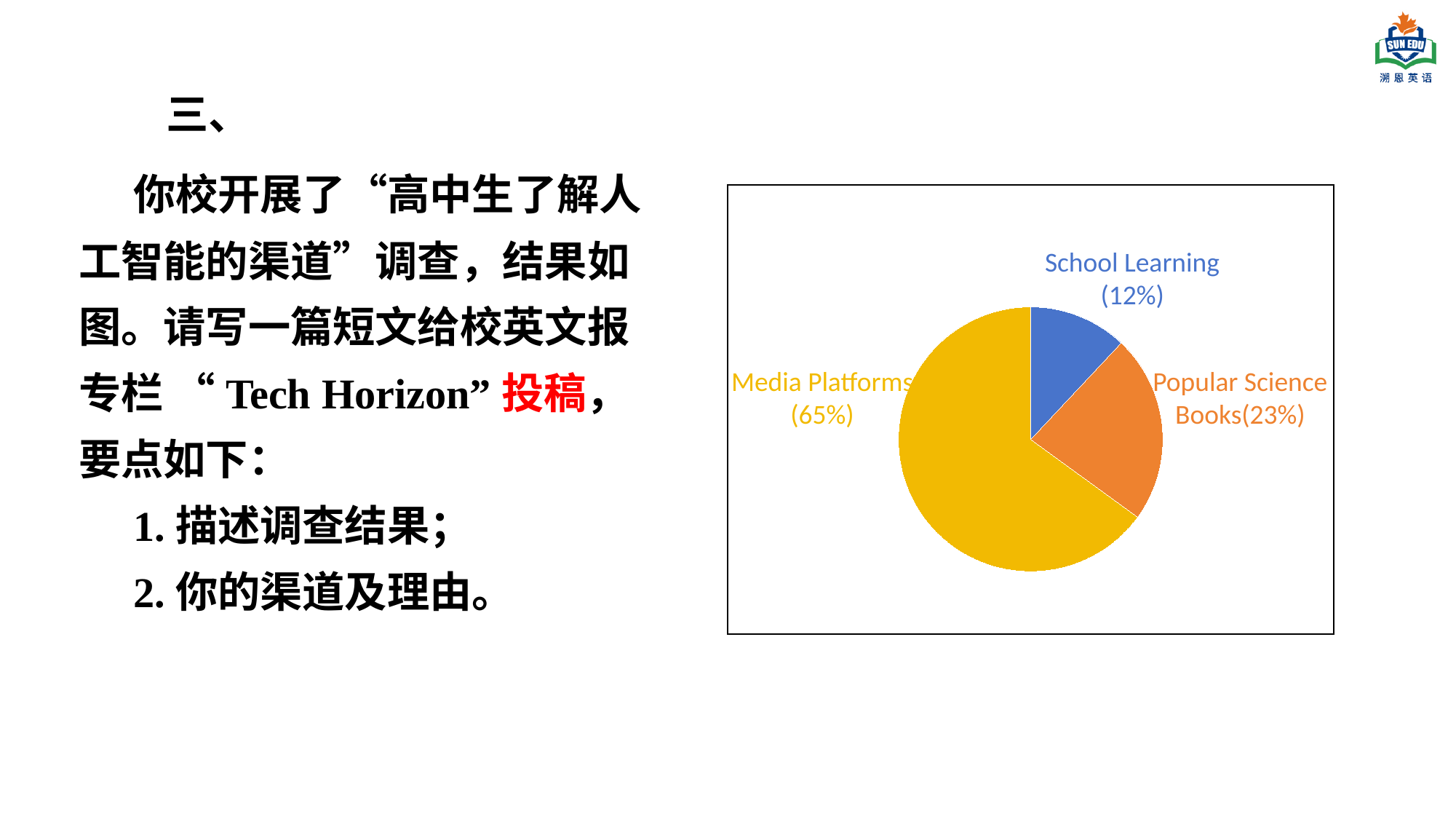
What is the difference in percentage points between Popular Science Books and School Learning? 11 What share of the pie does School Learning have? 12% Which is larger, the share for Popular Science Books or the share for School Learning? Popular Science Books What kind of chart is shown on the slide? pie chart What is the difference in percentage points between Media Platforms and Popular Science Books? 42 How many categories are shown in the pie chart? 3 What colour is the School Learning slice? blue Which category has the smallest slice of the pie? School Learning What share of the pie does Media Platforms have? 65% What colour is the Media Platforms slice? yellow What share of the pie does Popular Science Books have? 23% Which category has the largest slice of the pie? Media Platforms